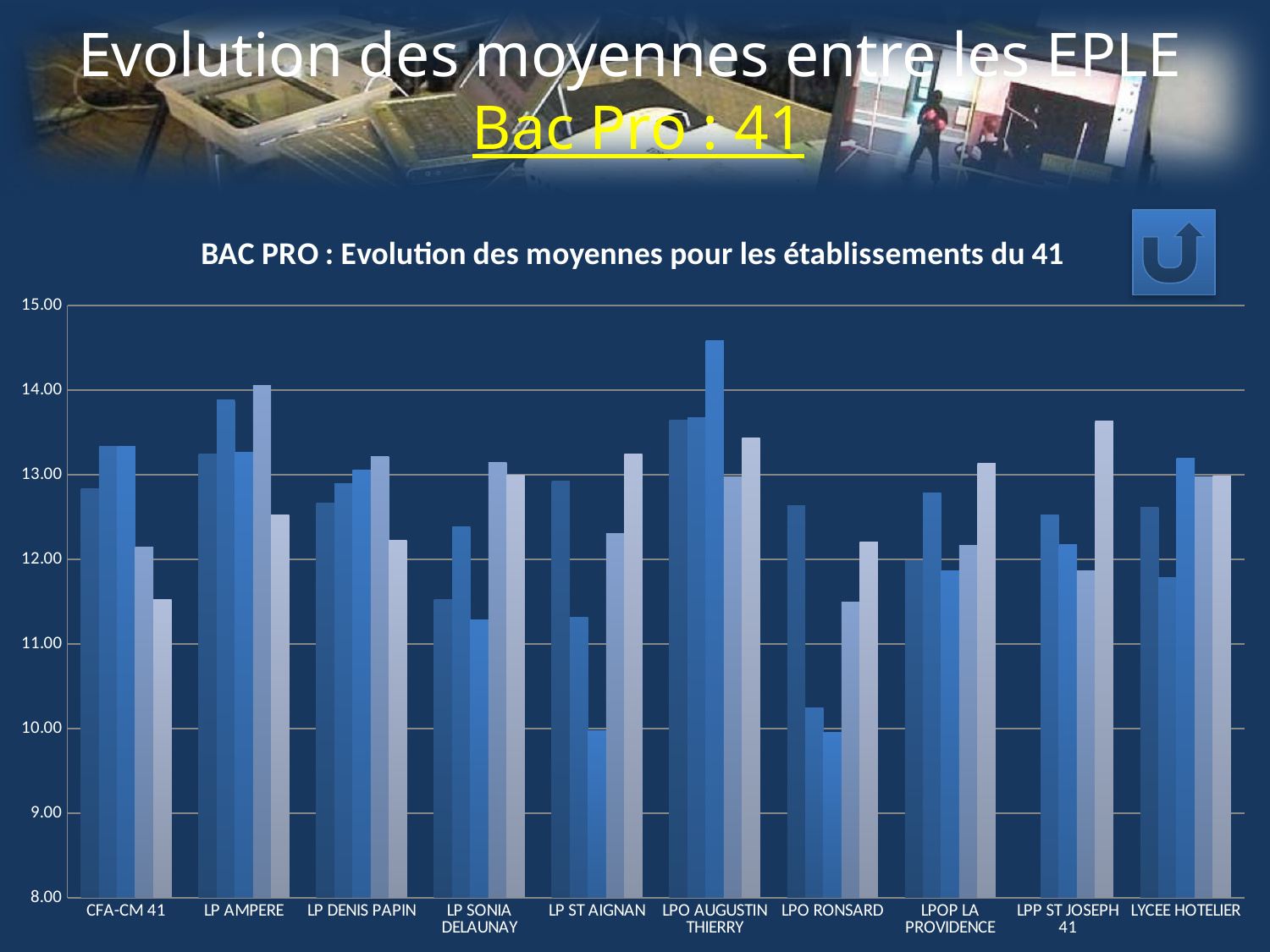
What is the title of the chart? BAC PRO : Evolution des moyennes pour les établissements du 41 Is the fourth bar for LPO RONSARD greater or less than 12.00? less Is the leftmost bar for CFA-CM 41 greater or less than 12.00? greater Is the tallest bar for LPO AUGUSTIN THIERRY greater or less than 14.00? greater Which is larger: the fourth bar for LPP ST JOSEPH 41 or the fourth bar for LPO RONSARD? LPP ST JOSEPH 41 Which is larger: the leftmost bar for LP AMPERE or the leftmost bar for LP SONIA DELAUNAY? LP AMPERE How many establishments (categories) are shown on the x axis of the chart? 10 Which establishment has the tallest bar in the chart? LPO AUGUSTIN THIERRY What kind of chart is shown on the slide? bar chart